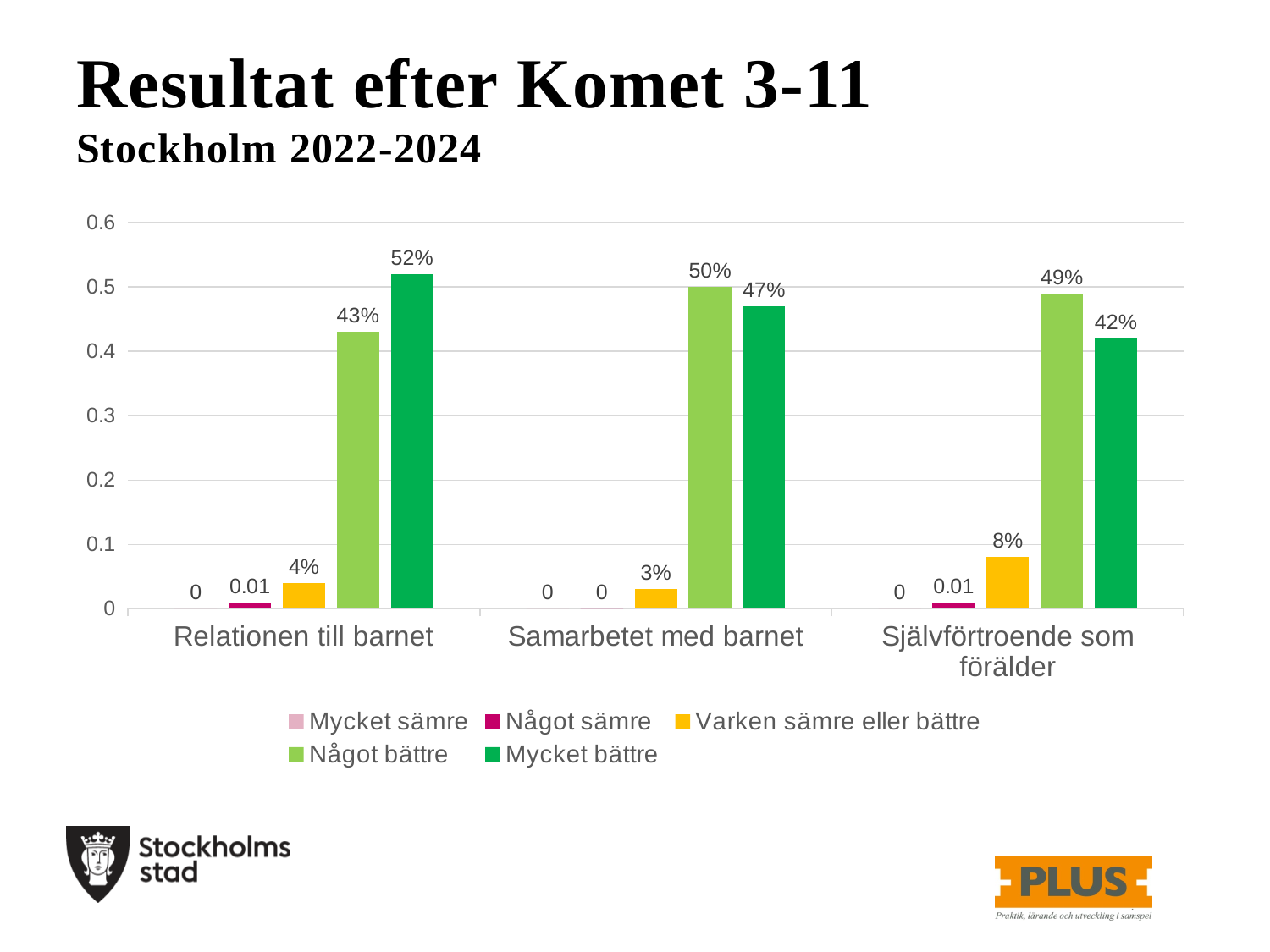
What is the value for "Mycket bättre" in the "Relationen till barnet" category? 52% In the "Samarbetet med barnet" category, which is larger: "Något bättre" or "Mycket bättre"? Något bättre What is the value for "Något bättre" in the "Samarbetet med barnet" category? 50% Which category has the lowest value for "Varken sämre eller bättre"? Samarbetet med barnet What is the value for "Något sämre" in the "Relationen till barnet" category? 0.01 What is the value for "Varken sämre eller bättre" in the "Självförtroende som förälder" category? 8% Which category has the highest value for "Mycket bättre"? Relationen till barnet Is the value for "Något bättre" in the "Relationen till barnet" category greater or less than 0.4? greater What kind of chart is shown on the slide? Bar chart What is the difference between the "Något bättre" and "Mycket bättre" values in the "Självförtroende som förälder" category? 7% How many series does the legend list? 5 How many categories are shown on the x axis? 3